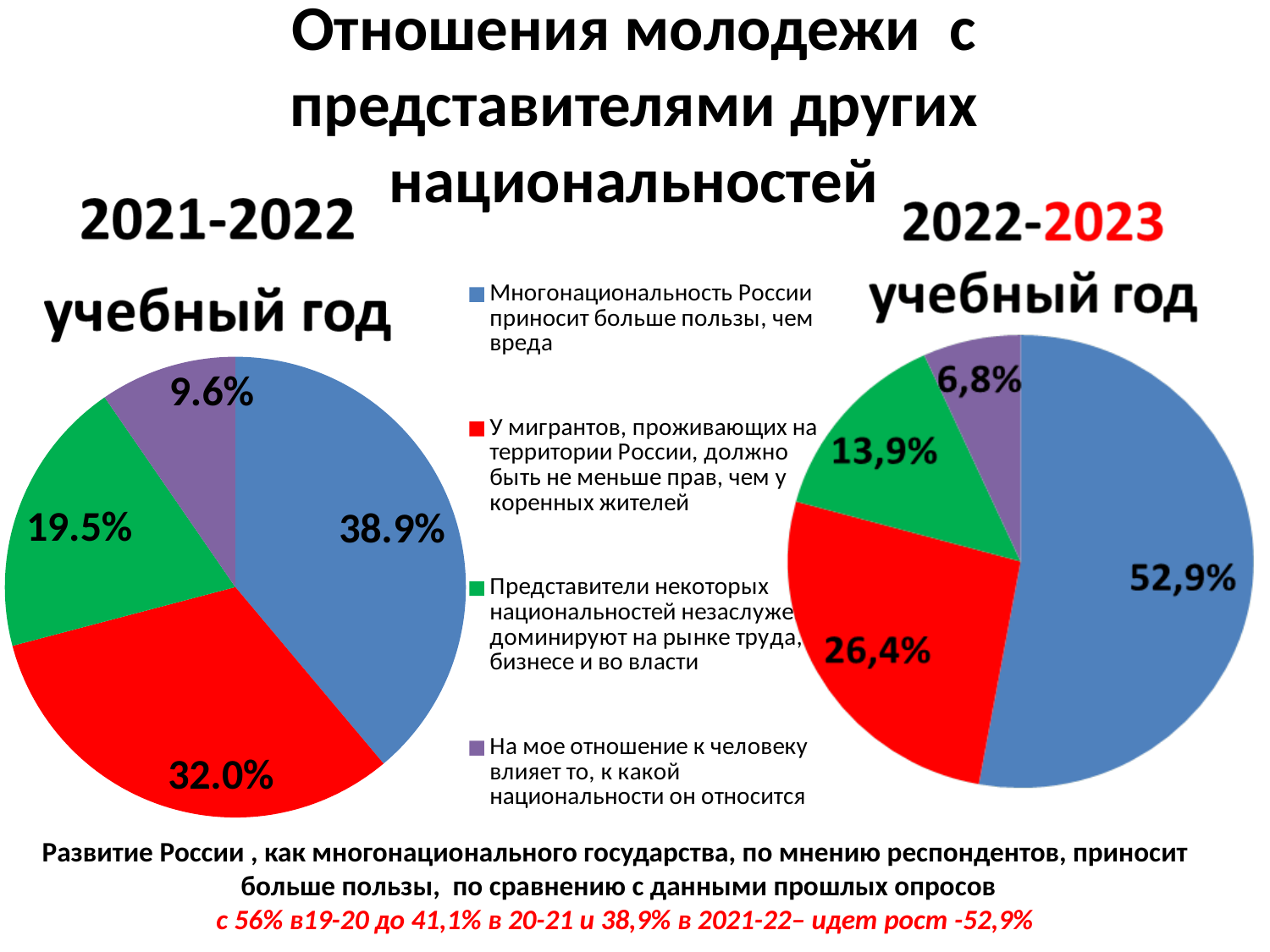
In the 2022-2023 учебный год chart, what share is shown for 'Многонациональность России приносит больше пользы, чем вреда' (blue slice)? 52,9% In the 2021-2022 учебный год chart, what share is shown for the red slice 'У мигрантов, проживающих на территории России, должно быть не меньше прав, чем у коренных жителей'? 32.0% What type of chart is used for the 2021-2022 учебный год data? pie chart In the 2022-2023 учебный год chart, which category has the smallest share? На мое отношение к человеку влияет то, к какой национальности он относится In the 2021-2022 учебный год chart, what share is shown for 'Многонациональность России приносит больше пользы, чем вреда' (blue slice)? 38.9% Which is larger: the green slice in the 2021-2022 учебный год chart or the green slice in the 2022-2023 учебный год chart? 2021-2022 учебный год (19.5%) How many entries does the legend between the two pie charts list? 4 How many slices does the 2022-2023 учебный год pie chart have? 4 What is the difference between the blue slice in the 2022-2023 учебный год chart (52,9%) and the blue slice in the 2021-2022 учебный год chart (38.9%)? 14 percentage points In the 2021-2022 учебный год chart, which category has the largest share? Многонациональность России приносит больше пользы, чем вреда In the 2021-2022 учебный год chart, what is the difference between the red slice (32.0%) and the green slice (19.5%)? 12.5 percentage points In the 2022-2023 учебный год chart, what share is shown for the purple slice 'На мое отношение к человеку влияет то, к какой национальности он относится'? 6,8%